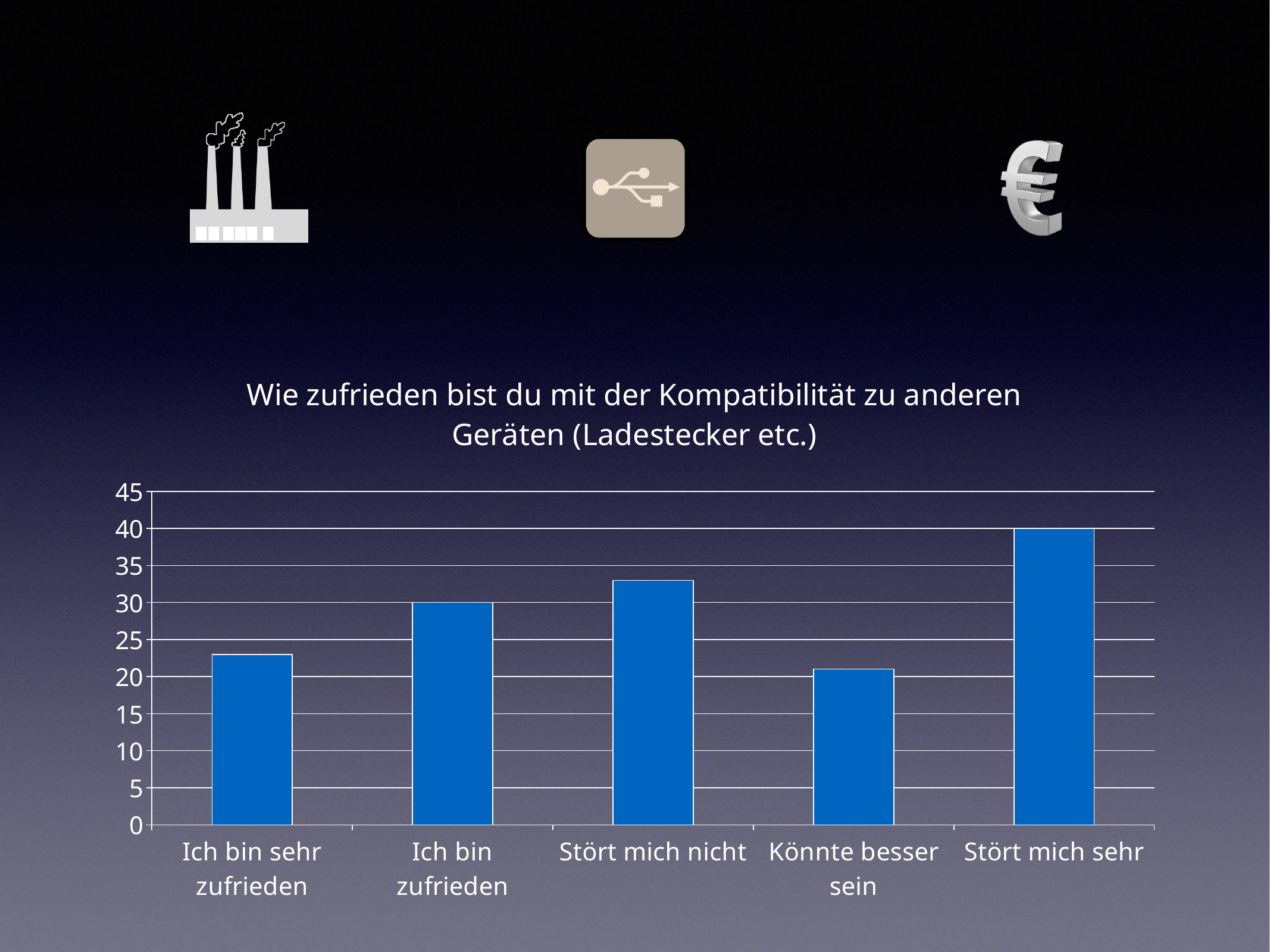
What is the difference between the values for "Stört mich sehr" and "Ich bin zufrieden"? 10 Is the value for "Stört mich nicht" greater or less than 35? less What is the value for "Ich bin zufrieden"? 30 How many categories are shown on the x axis of the chart? 5 Which is larger, the value for "Stört mich sehr" or the value for "Ich bin sehr zufrieden"? Stört mich sehr Is the value for "Stört mich nicht" greater or less than 30? greater Is the value for "Könnte besser sein" greater or less than 25? less What is the value for "Stört mich sehr"? 40 Which category has the highest value? Stört mich sehr What kind of chart is shown on the slide? bar chart What is the title of the chart? Wie zufrieden bist du mit der Kompatibilität zu anderen Geräten (Ladestecker etc.)